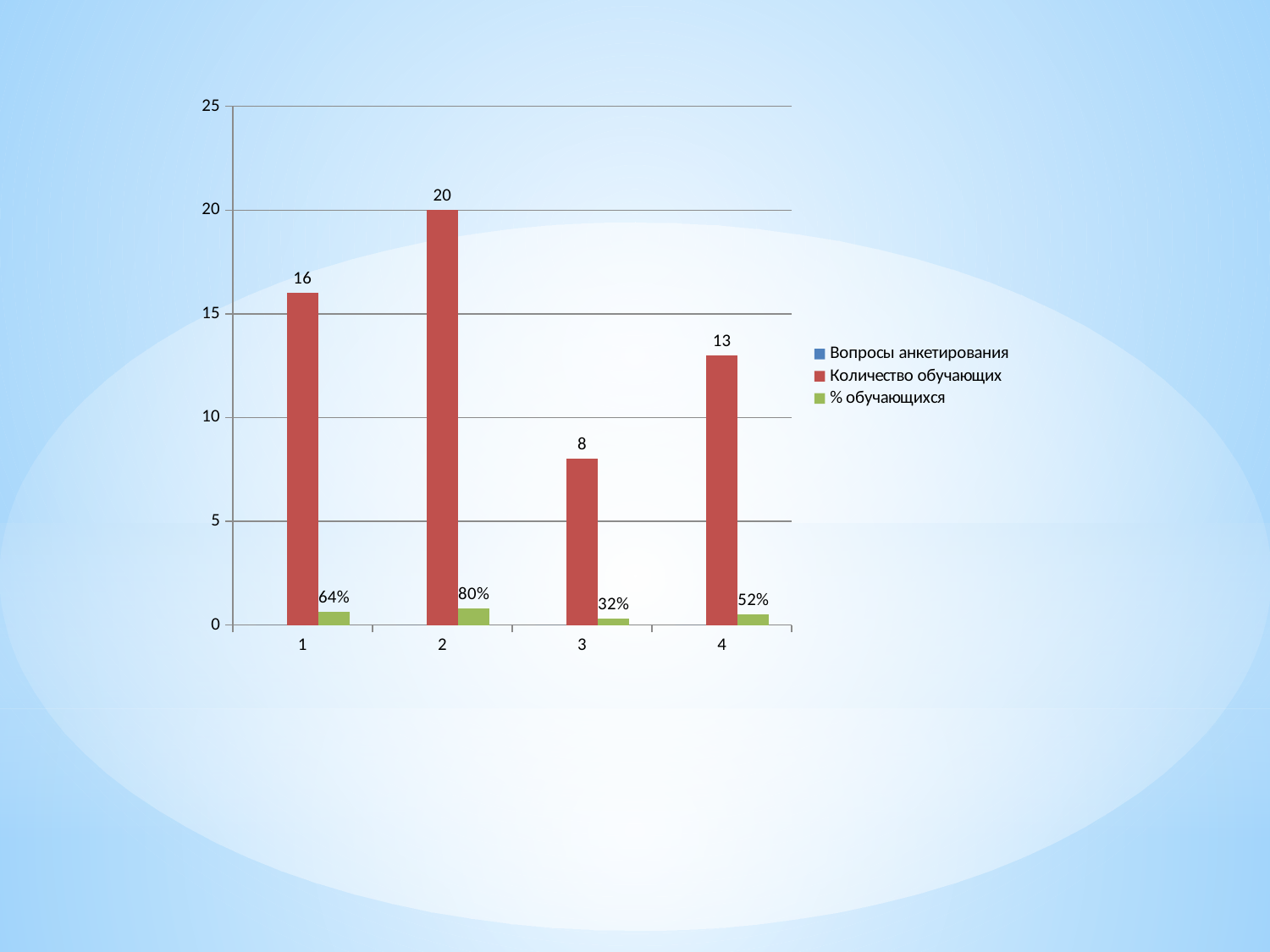
What is the value of "Количество обучающих" for category 2? 20 What kind of chart is shown on the slide? Bar chart Which category has the lowest value for "% обучающихся"? 3 What is the difference between the "Количество обучающих" values for categories 2 and 3? 12 How many categories are shown on the x axis? 4 Which is larger: the "Количество обучающих" value for category 1 or for category 4? Category 1 What is the value of "% обучающихся" for category 1? 64% What colour are the bars for the "% обучающихся" series? Green What is the value of "% обучающихся" for category 3? 32% How many series does the legend list? 3 Which category has the highest value for "Количество обучающих"? 2 What is the value of "Количество обучающих" for category 4? 13